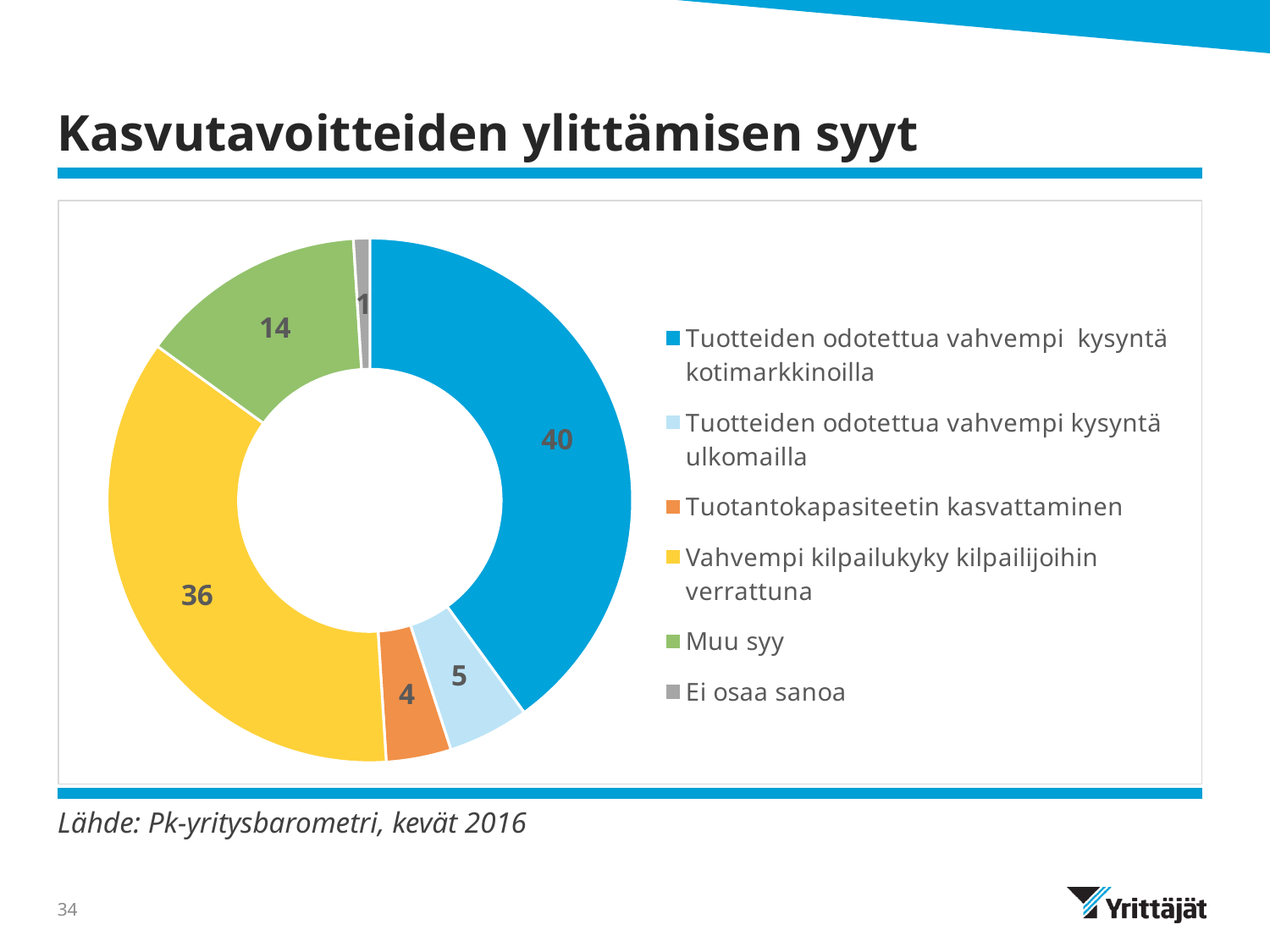
What is the title of the chart on the slide? Kasvutavoitteiden ylittämisen syyt What is the value for "Tuotantokapasiteetin kasvattaminen"? 4 What is the value for "Tuotteiden odotettua vahvempi kysyntä kotimarkkinoilla"? 40 What is the difference between the values for "Tuotteiden odotettua vahvempi kysyntä kotimarkkinoilla" and "Vahvempi kilpailukyky kilpailijoihin verrattuna"? 4 How many categories does the legend list? 6 What is the value for "Muu syy"? 14 Which category has the smallest slice? Ei osaa sanoa Which category has the largest slice? Tuotteiden odotettua vahvempi kysyntä kotimarkkinoilla Which is larger: the value for "Muu syy" or the value for "Tuotteiden odotettua vahvempi kysyntä ulkomailla"? Muu syy What kind of chart is shown on the slide? Doughnut (pie) chart What is the value for "Tuotteiden odotettua vahvempi kysyntä ulkomailla"? 5 What is the value for "Vahvempi kilpailukyky kilpailijoihin verrattuna"? 36